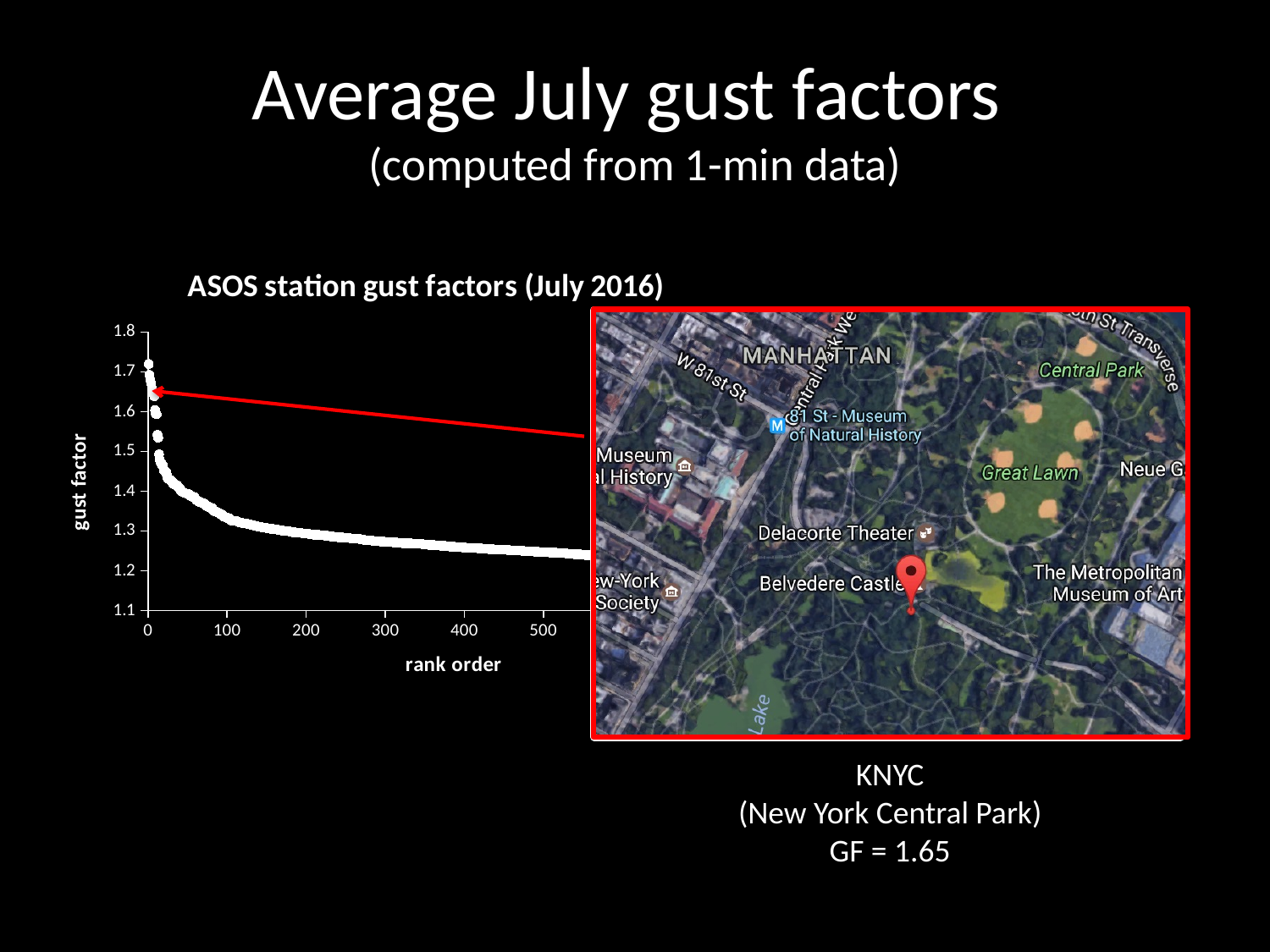
What is the label of the x axis of the chart? rank order What kind of chart is shown on the slide? scatter chart What is the title of the chart? ASOS station gust factors (July 2016) Which is larger, the gust factor at rank order 50 or at rank order 400? rank order 50 Is the gust factor at rank order 100 greater or less than 1.4? less Do the gust factor values rise or fall as rank order increases? fall Is the gust factor at rank order 500 greater or less than 1.3? less What gust factor is given for KNYC (New York Central Park)? 1.65 Is the gust factor at rank order 300 greater or less than 1.4? less